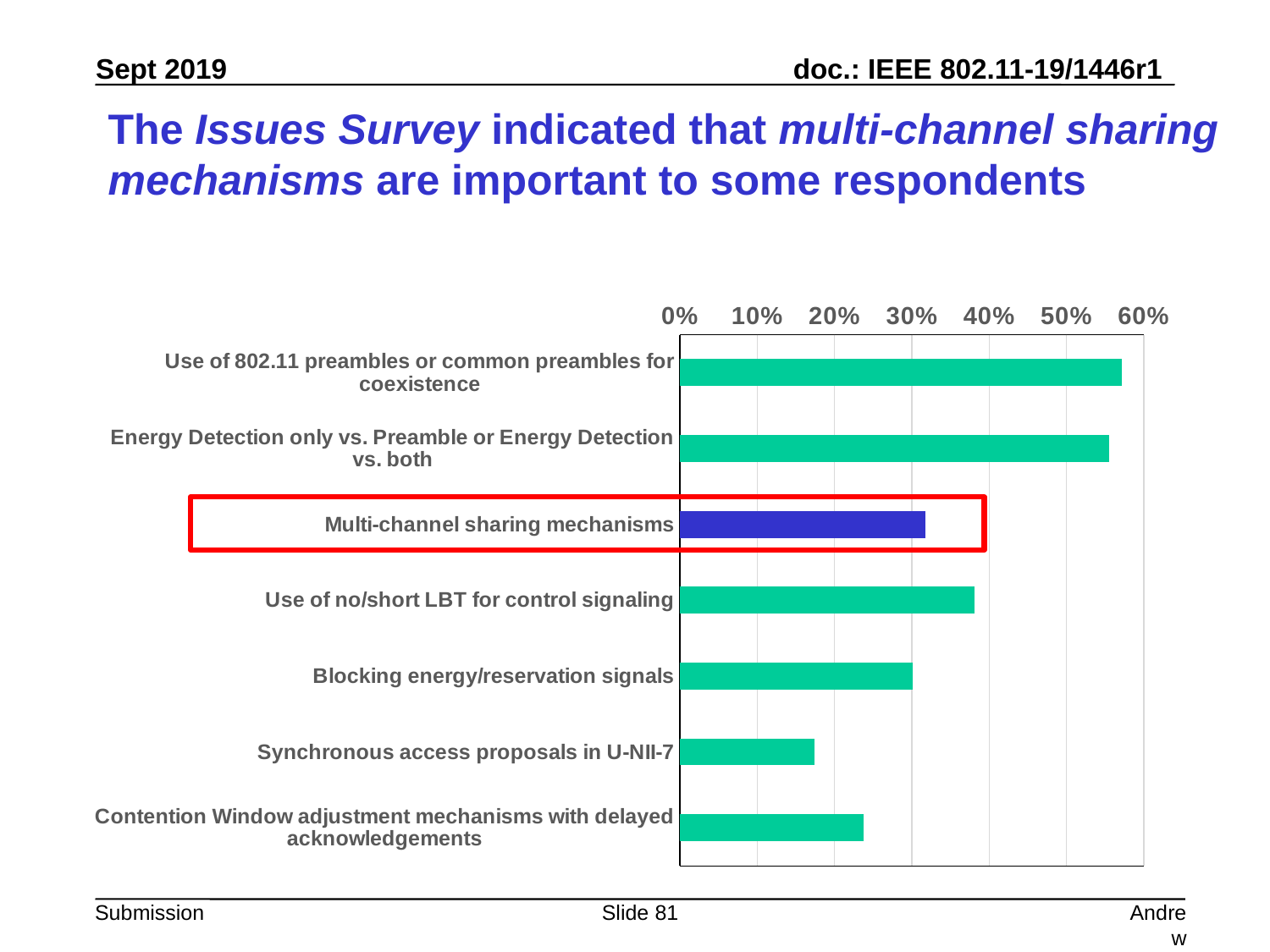
Which is larger: the value for Multi-channel sharing mechanisms or the value for Use of no/short LBT for control signaling? Use of no/short LBT for control signaling Is the value for Multi-channel sharing mechanisms greater or less than 40%? less Is the value for Synchronous access proposals in U-NII-7 greater or less than 20%? less Is the value for Contention Window adjustment mechanisms with delayed acknowledgements greater or less than 20%? greater Which category has the shortest bar in the chart? Synchronous access proposals in U-NII-7 Which category has the longest bar in the chart? Use of 802.11 preambles or common preambles for coexistence Which category's bar is drawn in a different colour (blue) and outlined with a red box? Multi-channel sharing mechanisms How many categories are plotted in the chart? 7 Which is larger: the value for Blocking energy/reservation signals or the value for Contention Window adjustment mechanisms with delayed acknowledgements? Blocking energy/reservation signals What kind of chart is shown on the slide? bar chart